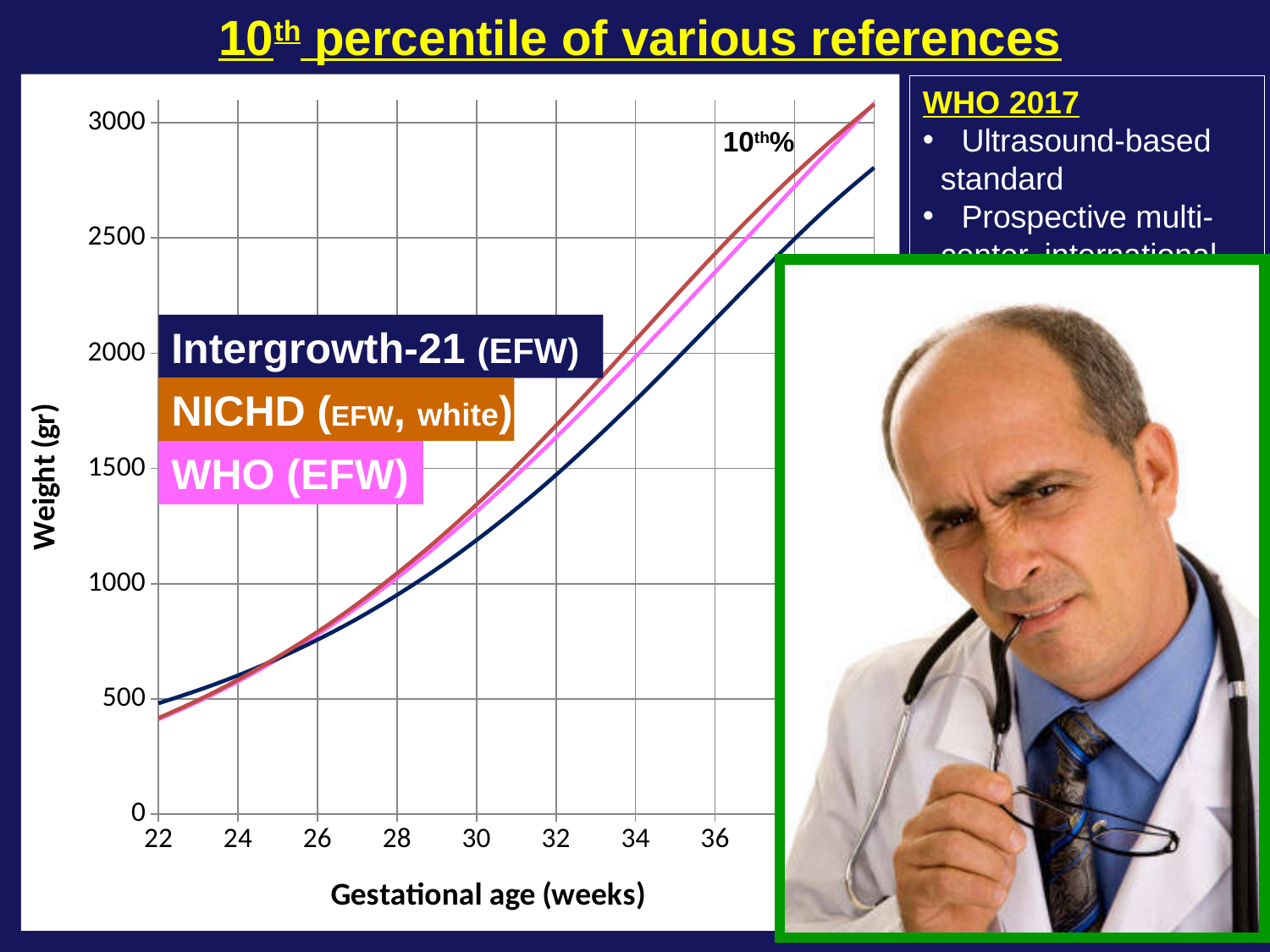
At 34 weeks, which is higher: NICHD (EFW, white) or Intergrowth-21 (EFW)? NICHD (EFW, white) Do the weight values rise or fall as gestational age increases? rise Is the WHO (EFW) value at 32 weeks greater or less than 1500? greater Is the Intergrowth-21 (EFW) value at 30 weeks greater or less than 1000? greater Is the Intergrowth-21 (EFW) value at 30 weeks greater or less than 1500? less How many series (references) are plotted on the chart? 3 What is the label of the y axis? Weight (gr) What kind of chart is shown on the slide? line chart Which series has the lowest weight at 36 weeks? Intergrowth-21 (EFW) At 22 weeks, which is higher: Intergrowth-21 (EFW) or NICHD (EFW, white)? Intergrowth-21 (EFW) What is the title of the slide's chart? 10th percentile of various references